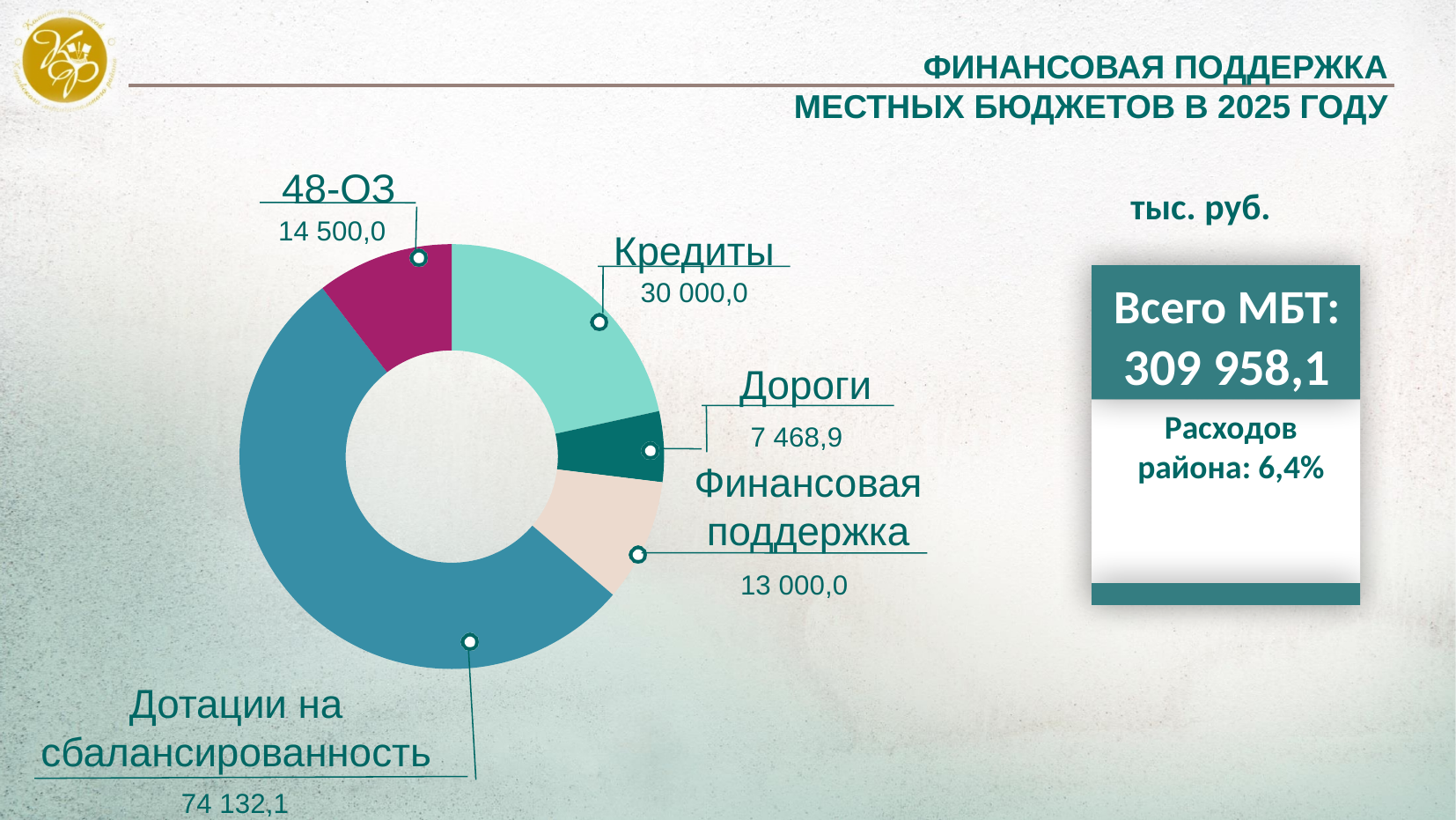
What is the value for 48-ОЗ? 14 500,0 Which is larger, 48-ОЗ or Финансовая поддержка? 48-ОЗ What is the difference between Финансовая поддержка and Дороги? 5 531,1 What type of chart is shown on the slide? Pie chart (donut) What is the difference between Кредиты and 48-ОЗ? 15 500,0 How many categories does the donut chart show? 5 In what units are the chart values given? тыс. руб. Which category has the smallest value? Дороги What is the value for Дотации на сбалансированность? 74 132,1 Which category has the largest value? Дотации на сбалансированность What is the value for Кредиты? 30 000,0 What is the value for Дороги? 7 468,9